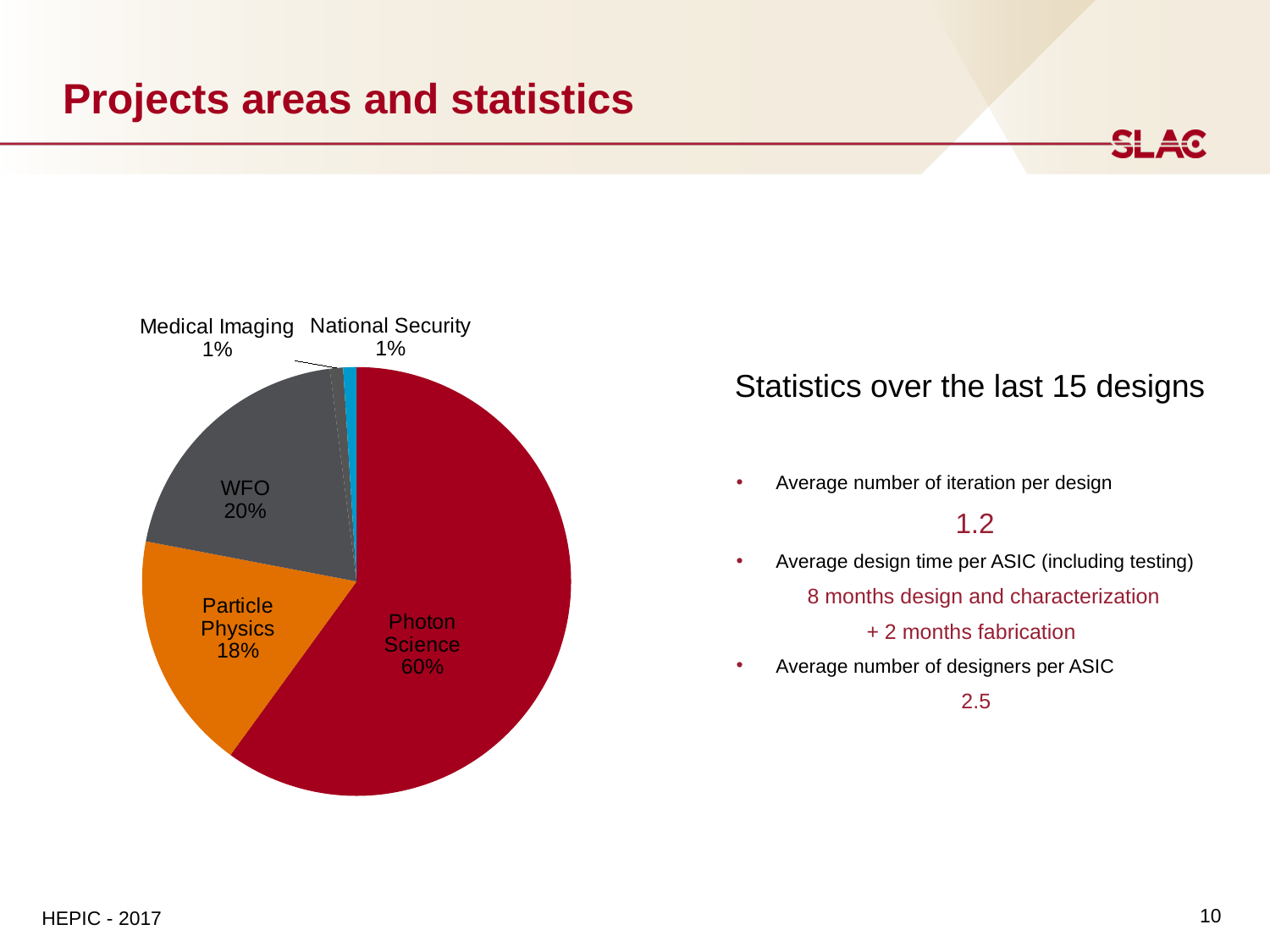
What kind of chart is shown on the slide? Pie chart Which is larger, the share for WFO or the share for Particle Physics? WFO What share of the pie does Photon Science have? 60% What is the value for Particle Physics? 18% What is the difference between the shares of Photon Science and WFO? 40% What is the difference between the shares of WFO and Particle Physics? 2% What colour is the Photon Science slice? Red How many categories are shown in the pie chart? 5 Which category has the largest share of the pie? Photon Science What is the value for National Security? 1% What is the value for Medical Imaging? 1% What is the value for WFO? 20%